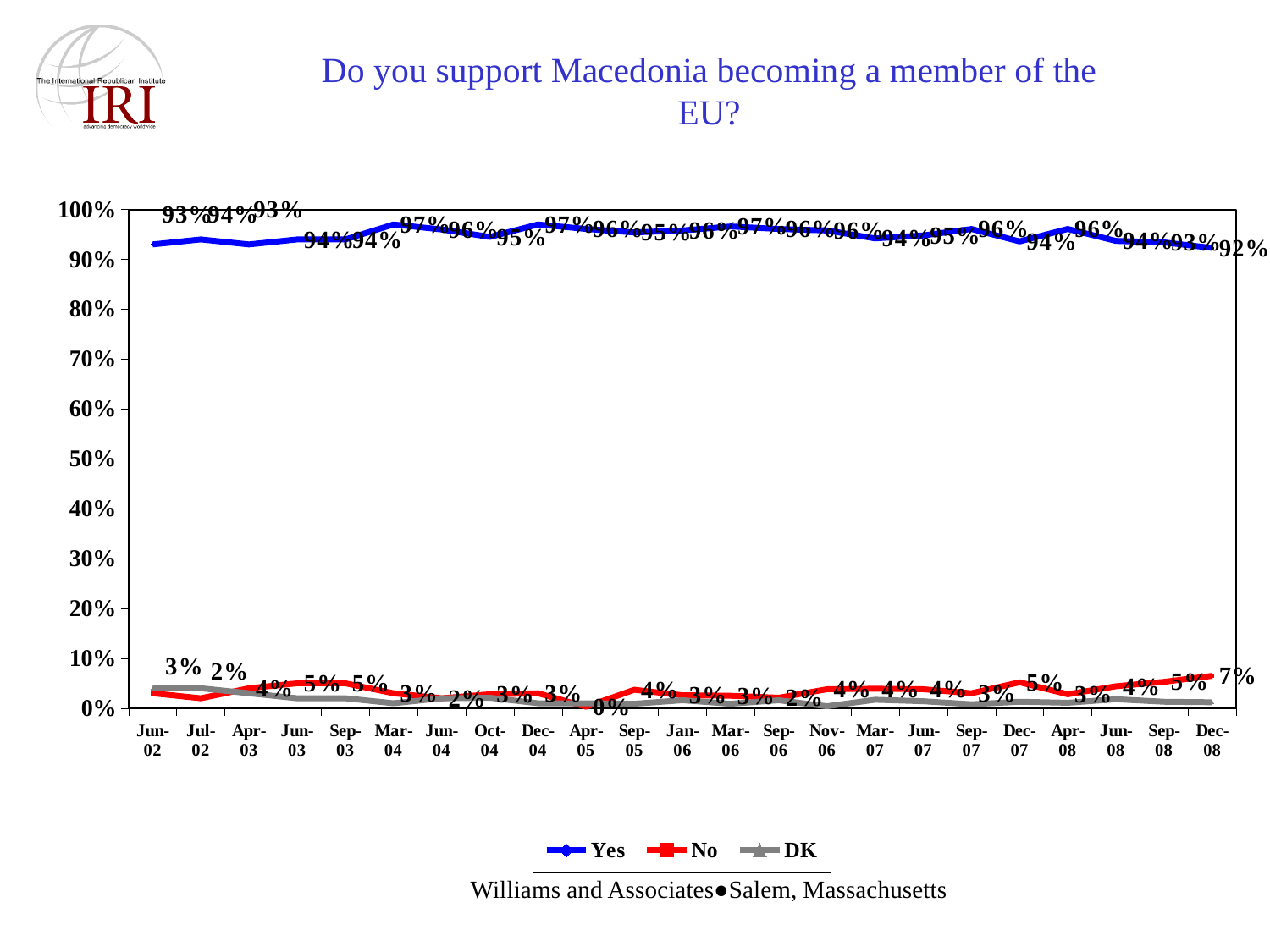
Does the Yes value rise or fall from Jun-08 to Dec-08? fall What is the No value for Dec-08? 7% What is the difference between the Yes value for Jun-02 and the Yes value for Dec-08? 1% At which date is the Yes value lowest? Dec-08 Which is larger, the Yes value for Mar-04 or the Yes value for Dec-08? Mar-04 What is the Yes value for Jun-02? 93% What is the highest Yes value shown on the chart? 97% What kind of chart is shown on the slide? line chart What is the Yes value for Dec-08? 92% How many series does the legend list? 3 How many survey dates are plotted along the x axis? 23 What are the three series listed in the legend? Yes, No, DK